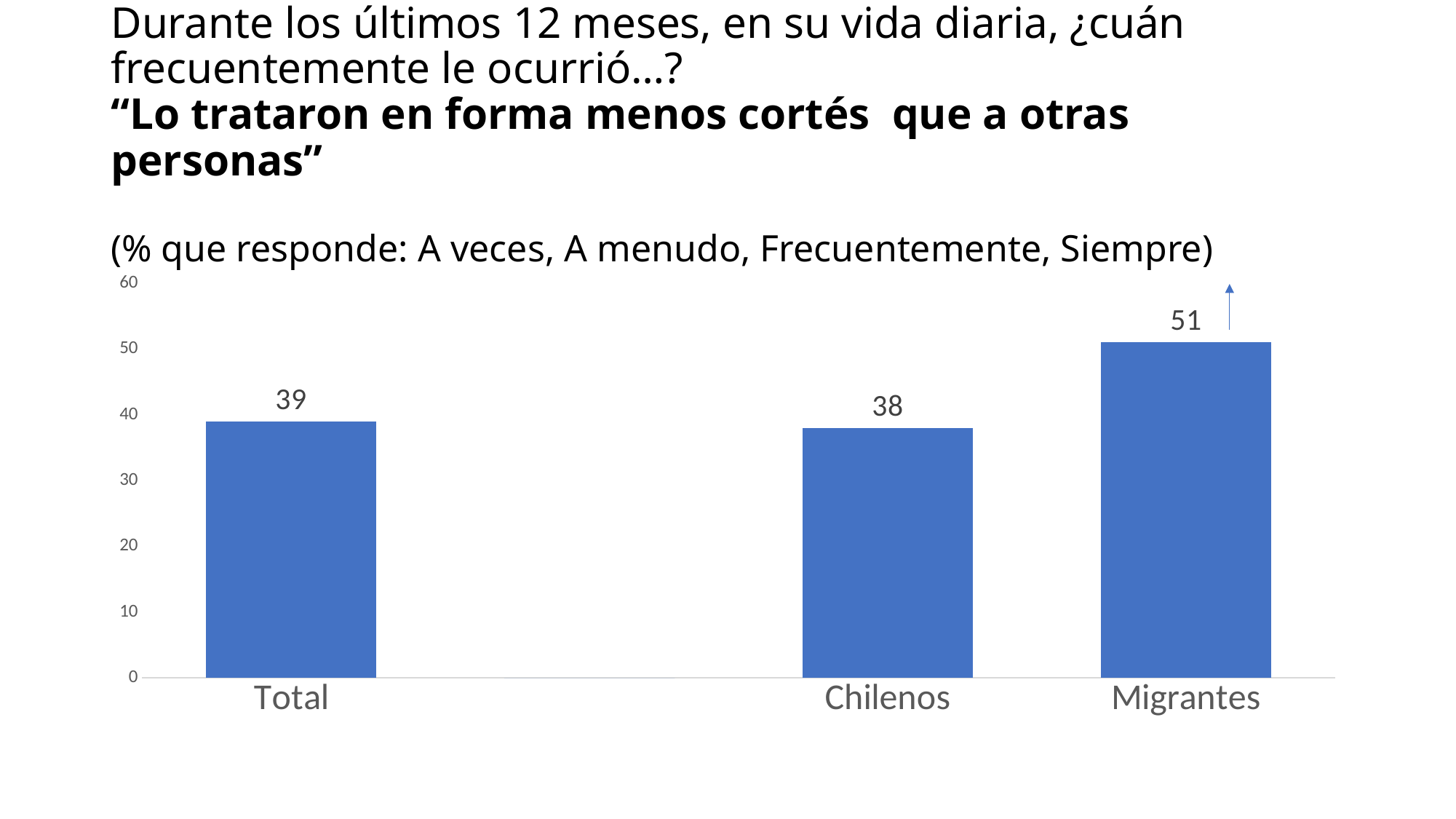
How many categories are shown on the x axis? 3 What is the difference between the values for Migrantes and Chilenos? 13 Which is larger, the value for Migrantes or the value for Total? Migrantes Is the value for Migrantes greater or less than 50? greater What is the value for Total? 39 What kind of chart is shown on the slide? bar chart What is the value for Migrantes? 51 What is the difference between the values for Migrantes and Total? 12 Which category has the highest value? Migrantes Which category has the lowest value? Chilenos What is the value for Chilenos? 38 What is the highest value shown on the y axis? 60